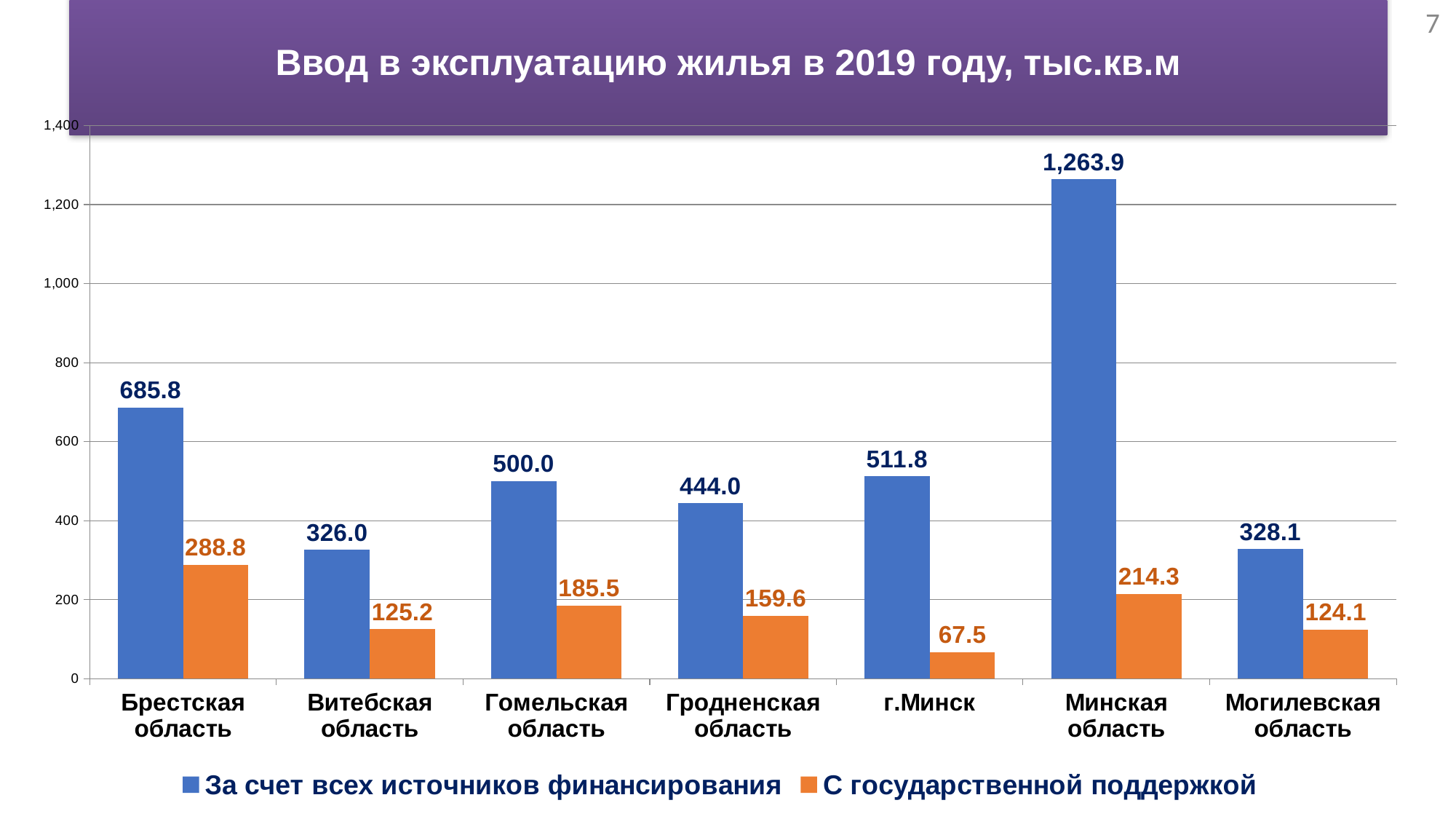
What is the title of the chart? Ввод в эксплуатацию жилья в 2019 году, тыс.кв.м What is the value for Брестская область in the series 'С государственной поддержкой'? 288.8 What is the value for Минская область in the series 'За счет всех источников финансирования'? 1,263.9 What is the value for г.Минск in the series 'С государственной поддержкой'? 67.5 Which region has the highest value in the series 'За счет всех источников финансирования'? Минская область Is the value for Витебская область in the series 'За счет всех источников финансирования' greater or less than 400? less Which is larger: the 'За счет всех источников финансирования' value for Гродненская область or for г.Минск? г.Минск What is the difference between the two series for Гомельская область? 314.5 How many regions are shown on the x axis? 7 How many series does the legend list? 2 What kind of chart is shown on the slide? bar chart Which region has the lowest value in the series 'С государственной поддержкой'? г.Минск